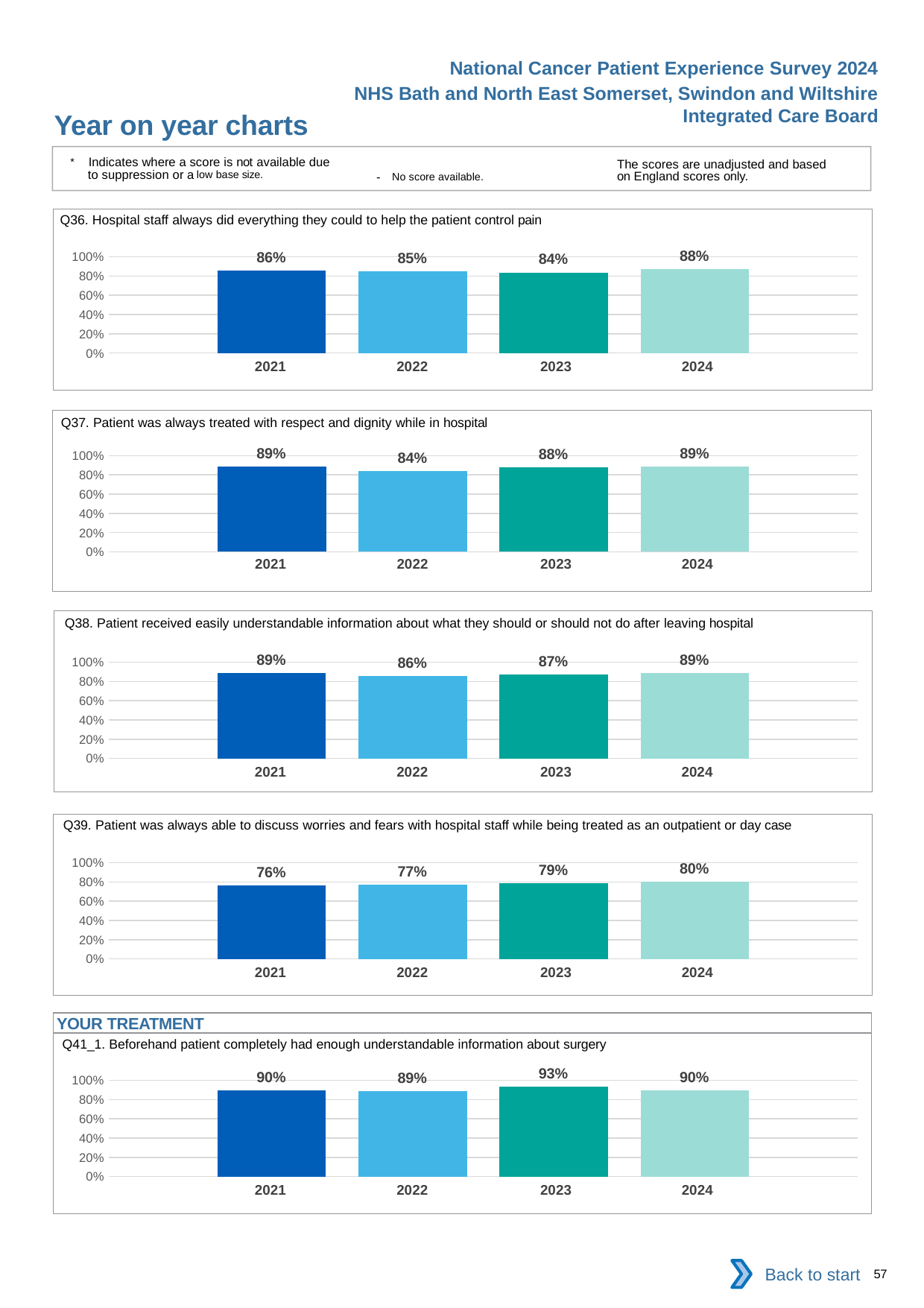
What kind of chart is the Q36 chart? bar chart In the Q37 chart, what is the difference between the 2021 and 2022 values? 5% In the Q36 chart, what is the value for 2024? 88% In the Q36 chart, which year has the lowest value? 2023 In the Q39 chart, do the values rise or fall from 2021 to 2024? rise How many years are shown in the Q39 chart? 4 In the Q41_1 chart, what is the difference between the 2023 and 2022 values? 4% In the Q38 chart, what is the value for 2023? 87% In the Q37 chart, what is the value for 2022? 84% In the Q39 chart, what is the value for 2021? 76% In the Q38 chart, which is larger, the value for 2022 or the value for 2023? 2023 In the Q41_1 chart, which year has the highest value? 2023